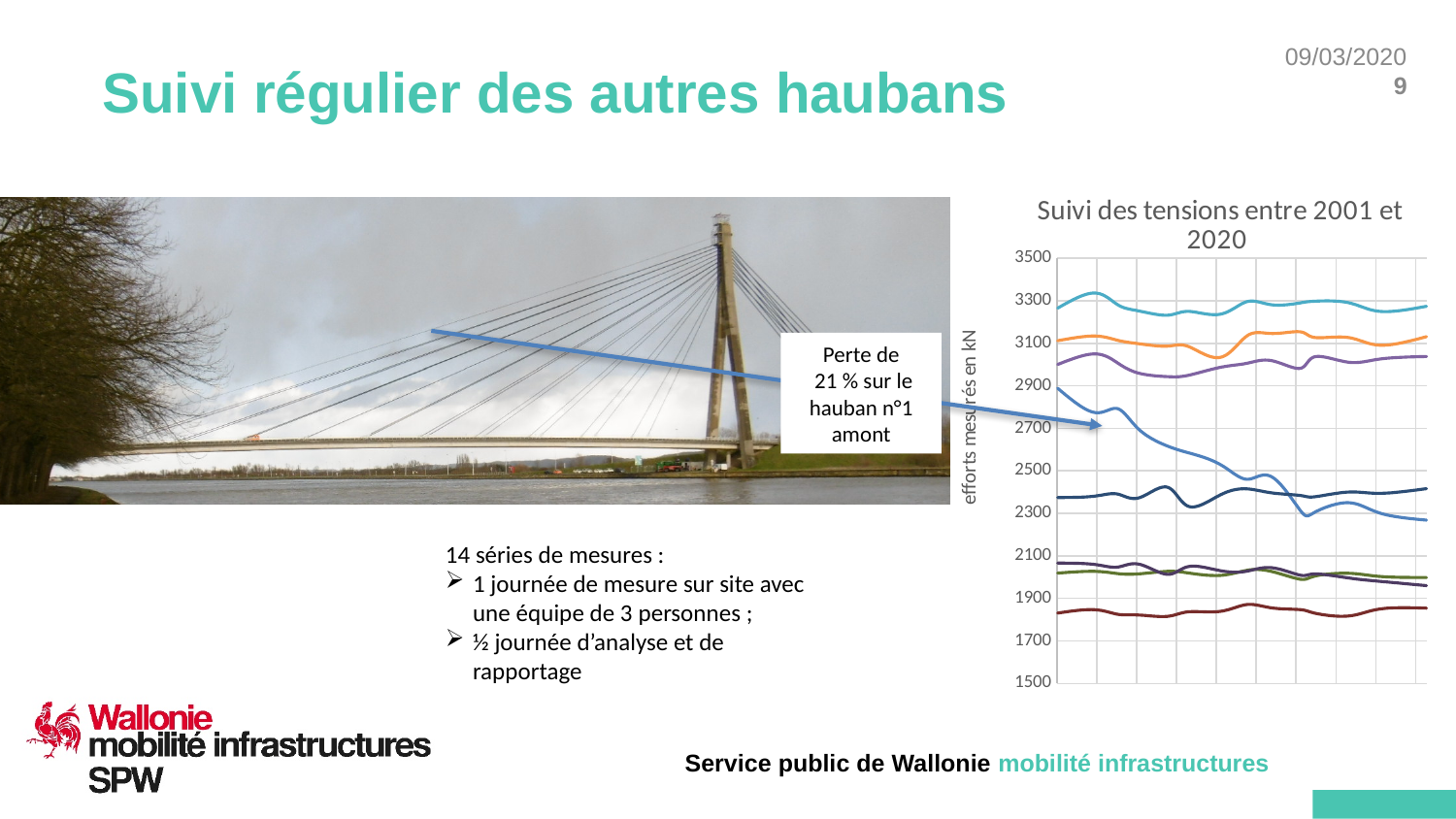
What is the title of the chart on the slide? Suivi des tensions entre 2001 et 2020 Is the value of the lowest (dark red) line greater or less than 1900 kN across the chart? less Is the value of the topmost (light blue) line greater or less than 3100 kN across the chart? greater At the right end of the chart, is the value of the falling blue line greater or less than 2300 kN? less Which line is the highest on the chart? The light blue line Does the blue line that starts near 2900 kN rise or fall from left to right? Fall What is the label of the vertical axis of the chart? efforts mesurés en kN What is the lowest value shown on the vertical axis of the chart? 1500 What kind of chart is shown on the slide? Line chart Which line is the lowest on the chart? The dark red line What is the highest value shown on the vertical axis of the chart? 3500